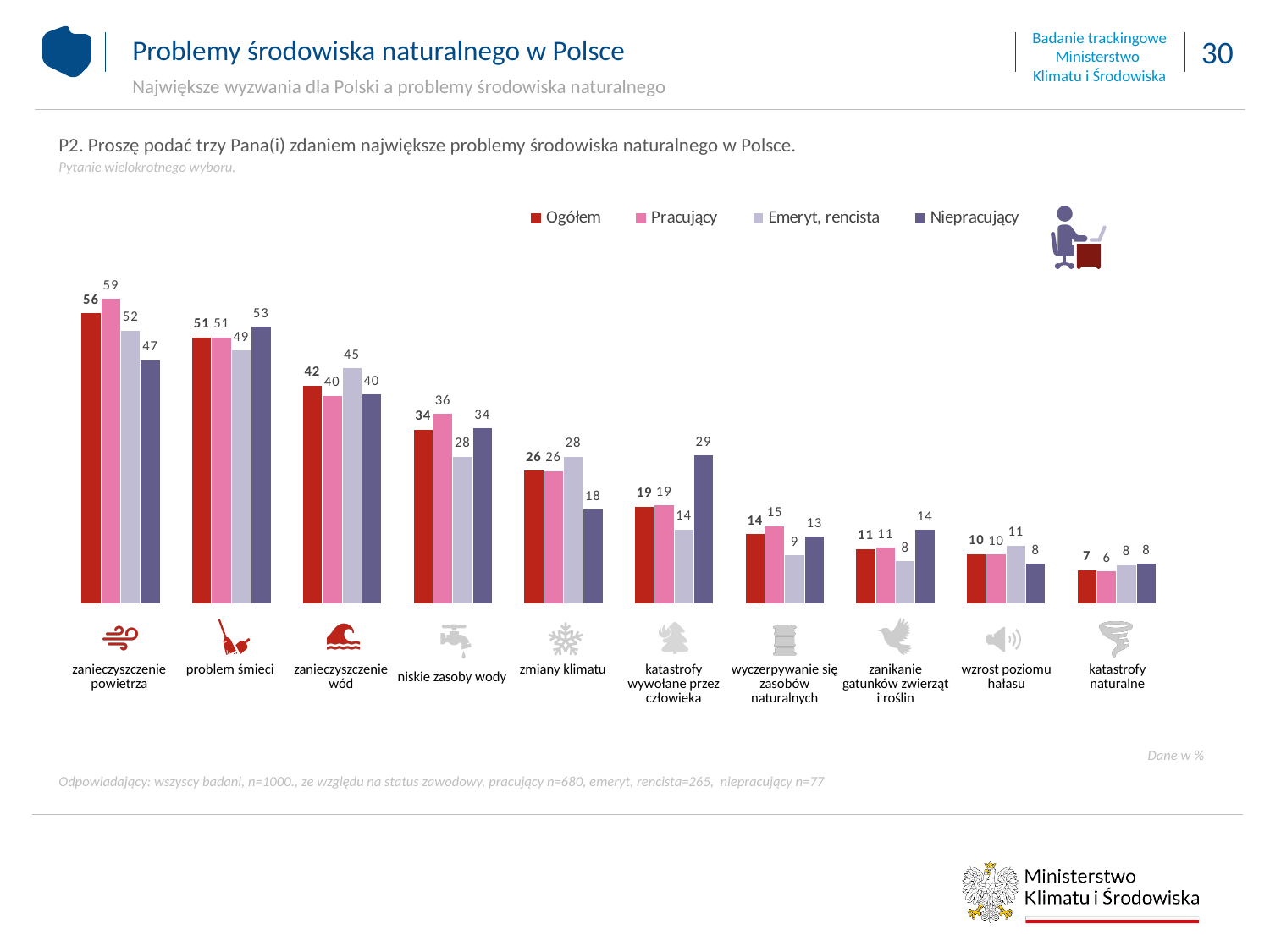
Which category has the lowest Pracujący value? katastrofy naturalne Which category has the highest Ogółem value? zanieczyszczenie powietrza For zmiany klimatu, which is larger: the Emeryt, rencista value or the Niepracujący value? Emeryt, rencista How many categories are shown on the x axis? 10 What is the Ogółem value for zanieczyszczenie powietrza? 56 What kind of chart is shown on the slide? bar chart What is the Emeryt, rencista value for zanieczyszczenie wód? 45 How many series does the legend list? 4 What is the Niepracujący value for katastrofy wywołane przez człowieka? 29 Which series is shown in red in the legend? Ogółem What is the difference between the Pracujący and Niepracujący values for zanieczyszczenie powietrza? 12 Do the Ogółem values rise or fall from left to right along the x axis? fall